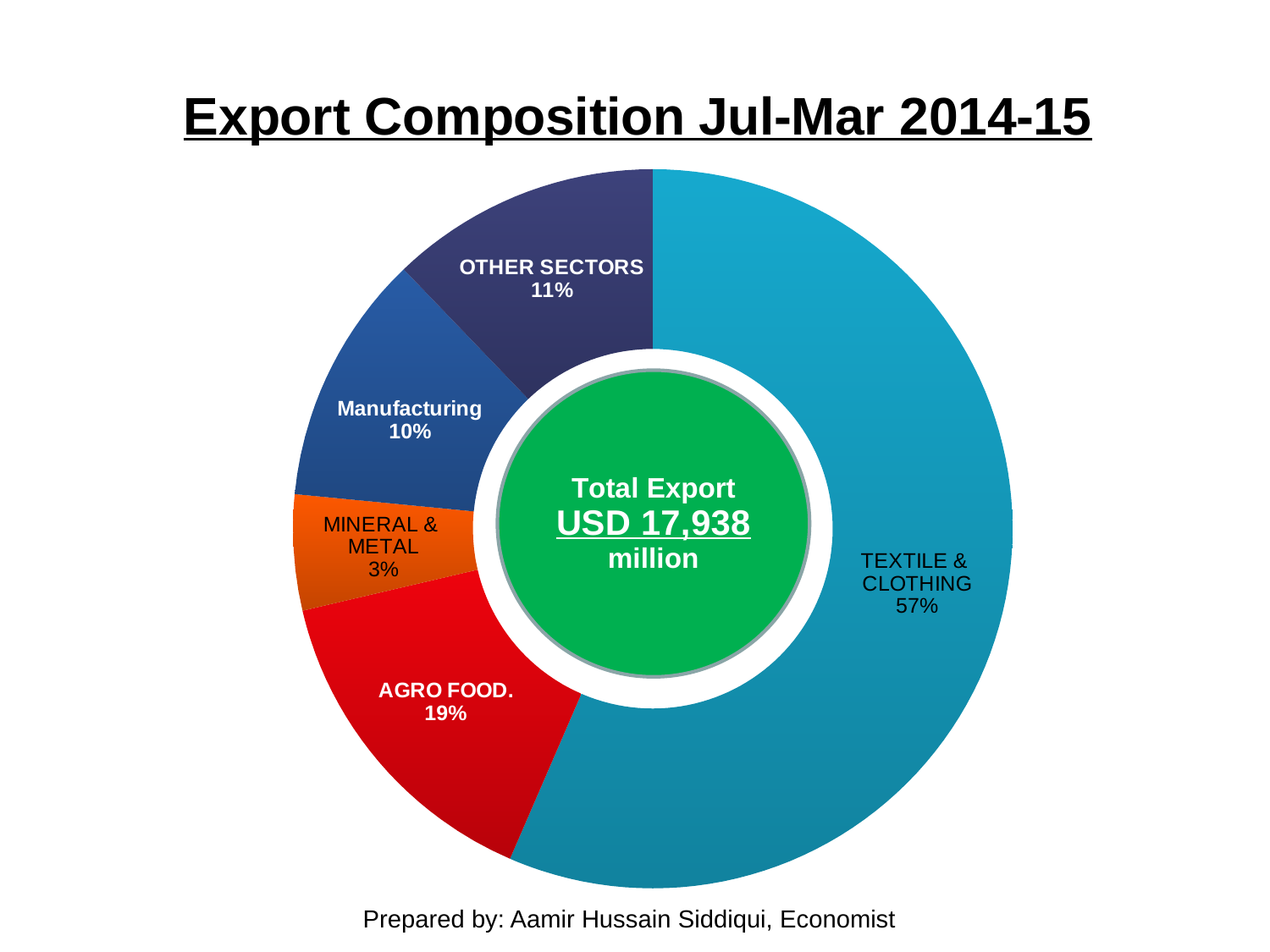
Which has a larger share, OTHER SECTORS or Manufacturing? OTHER SECTORS What share of exports does Manufacturing account for? 10% What share of exports does AGRO FOOD. account for? 19% What share of exports does MINERAL & METAL account for? 3% What share of exports does TEXTILE & CLOTHING account for? 57% What kind of chart is shown on the slide? Doughnut chart What is the difference in percentage points between the TEXTILE & CLOTHING share and the AGRO FOOD. share? 38 How many sectors are shown in the chart? 5 Which sector has the smallest share of exports? MINERAL & METAL Which sector has the largest share of exports? TEXTILE & CLOTHING What share of exports does OTHER SECTORS account for? 11% What total export value is shown in the centre of the chart? USD 17,938 million